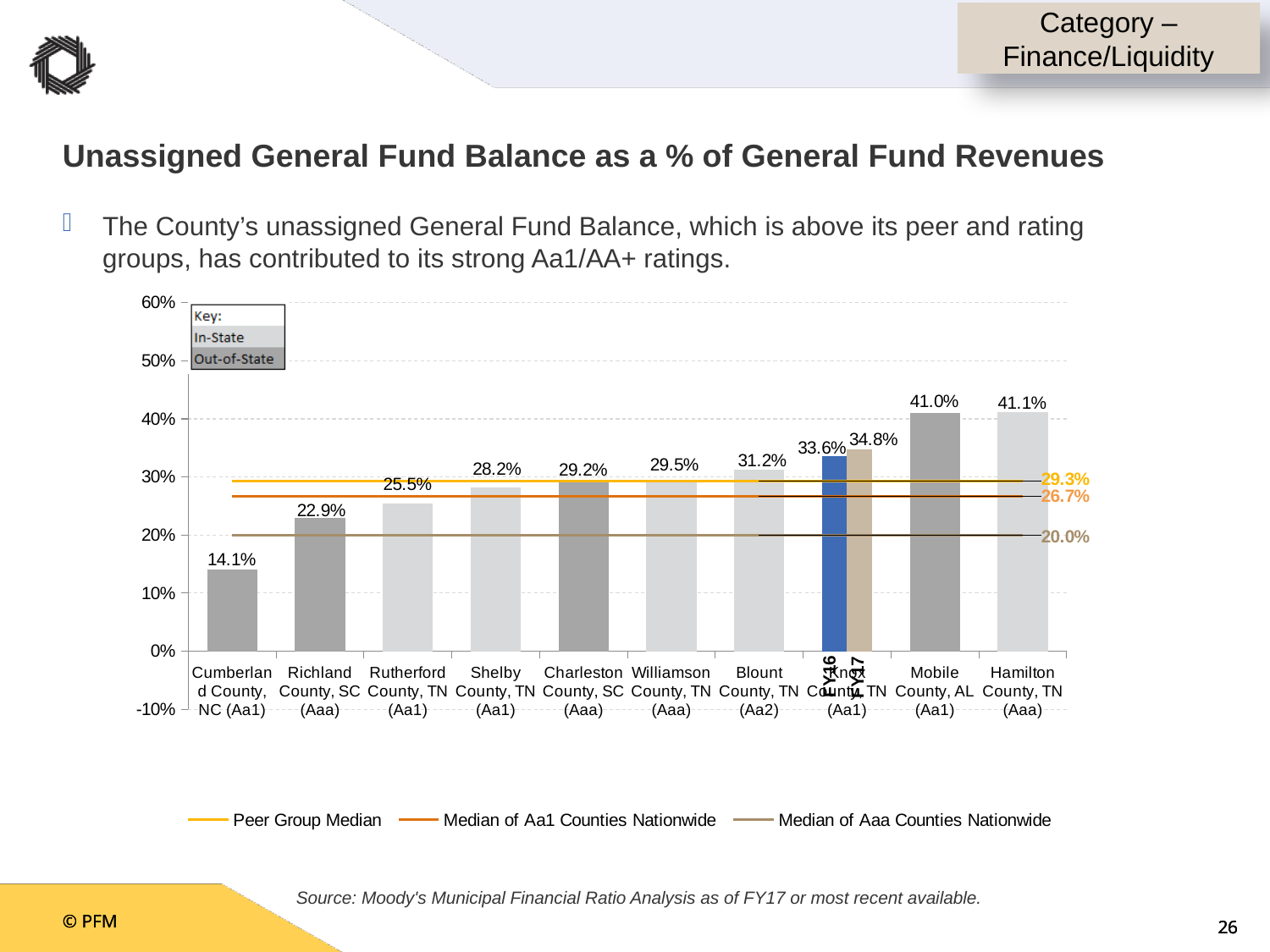
Which is larger, the value for Richland County, SC (Aaa) or Rutherford County, TN (Aa1)? Rutherford County, TN (Aa1) Which county has the lowest unassigned General Fund Balance as a % of General Fund Revenues? Cumberland County, NC (Aa1) What value is shown for Mobile County, AL (Aa1)? 41.0% What value is labeled on the FY17 bar? 34.8% What value is shown for Blount County, TN (Aa2)? 31.2% Is the value for Cumberland County, NC (Aa1) greater or less than 20%? less What is the value of the Peer Group Median line? 29.3% How many median lines does the legend at the bottom of the chart list? 3 What is the unassigned General Fund Balance as a % of General Fund Revenues for Cumberland County, NC (Aa1)? 14.1% What is the difference between the values for Shelby County, TN (Aa1) and Rutherford County, TN (Aa1)? 2.7 percentage points What is the value of the Median of Aaa Counties Nationwide line? 20.0% What kind of chart is shown on the slide? Combination bar and line chart (bars with three horizontal median lines)